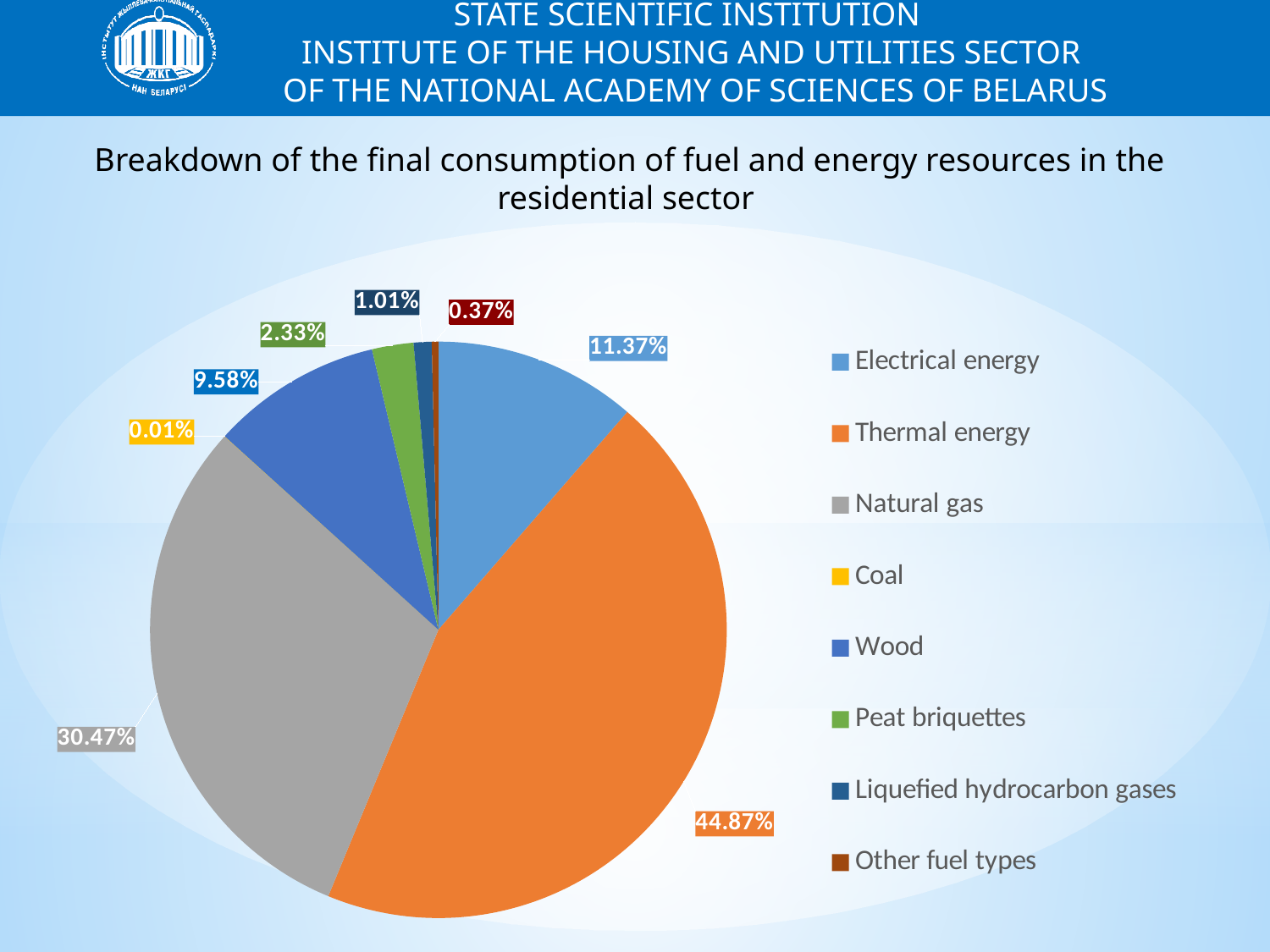
What is the value shown for Natural gas? 30.47% Which category has the largest share of the pie? Thermal energy What is the value shown for Electrical energy? 11.37% How many categories does the legend list? 8 Which category has the smallest share of the pie? Coal What share of final consumption does Thermal energy account for? 44.87% What percentage is shown for Peat briquettes? 2.33% What percentage is shown for Wood? 9.58% What kind of chart is shown on the slide? Pie chart Which is larger, the share for Electrical energy or the share for Wood? Electrical energy What is the title of the chart? Breakdown of the final consumption of fuel and energy resources in the residential sector What is the difference between the shares of Thermal energy and Natural gas? 14.40%